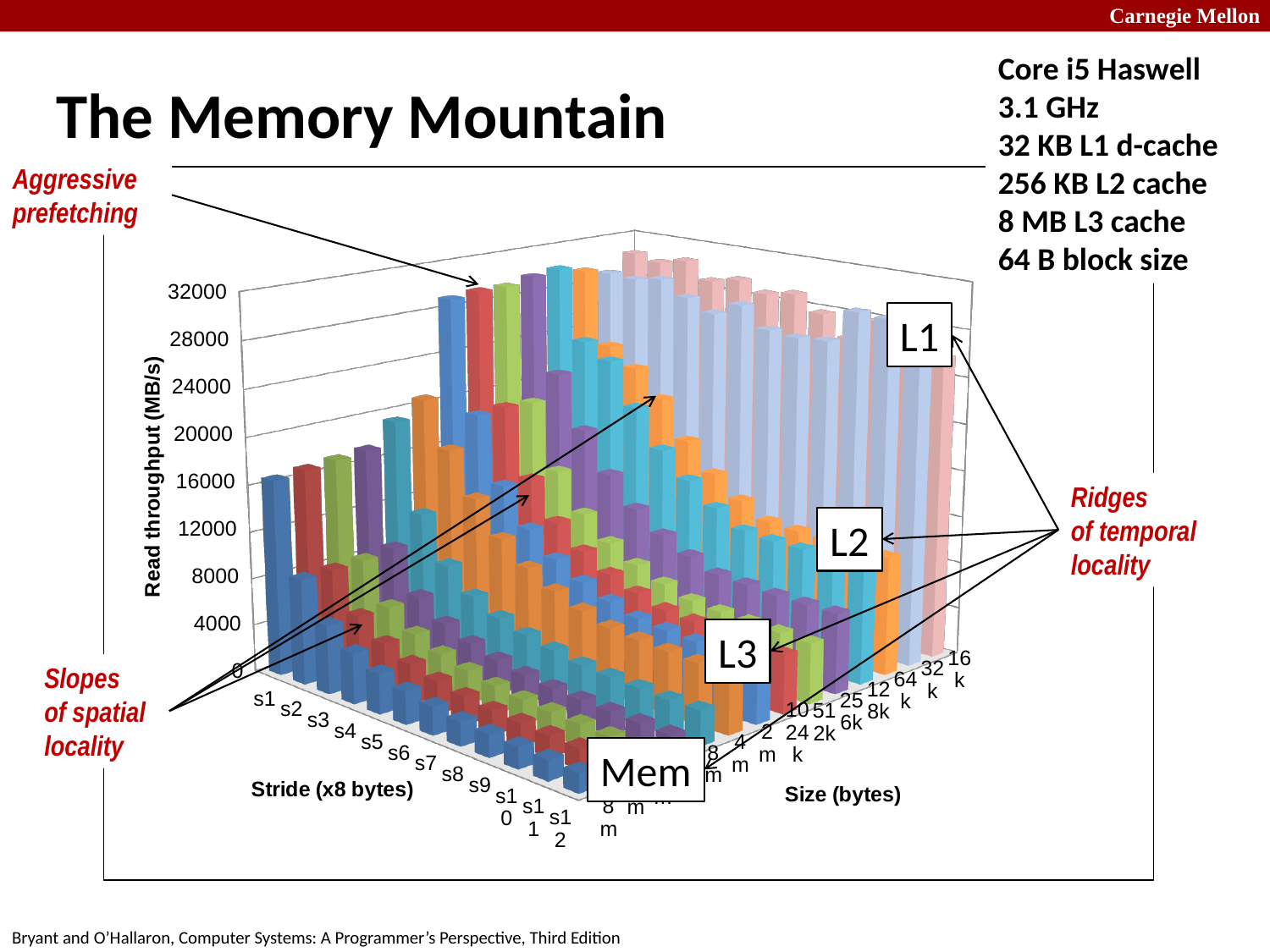
What is the interval between consecutive ticks on the read throughput axis? 4000 What kind of chart is shown on the slide? 3D bar chart For stride s1, does read throughput generally rise or fall as the working-set size increases from 16k to the largest size? fall How many stride categories (s1 through s12) are plotted along the stride axis? 12 Is the read throughput for stride s12 at the largest size (back-left corner of the chart) greater or less than 8000? less What is the label of the vertical axis of the chart? Read throughput (MB/s) Which stride has the higher read throughput at size 16k: s1 or s12? s1 Is the read throughput for stride s1 at size 16k greater or less than 24000? greater What is the highest tick value shown on the read throughput axis? 32000 For a fixed size, does read throughput generally rise or fall as the stride increases from s1 to s12? fall What is the title of the chart on the slide? The Memory Mountain